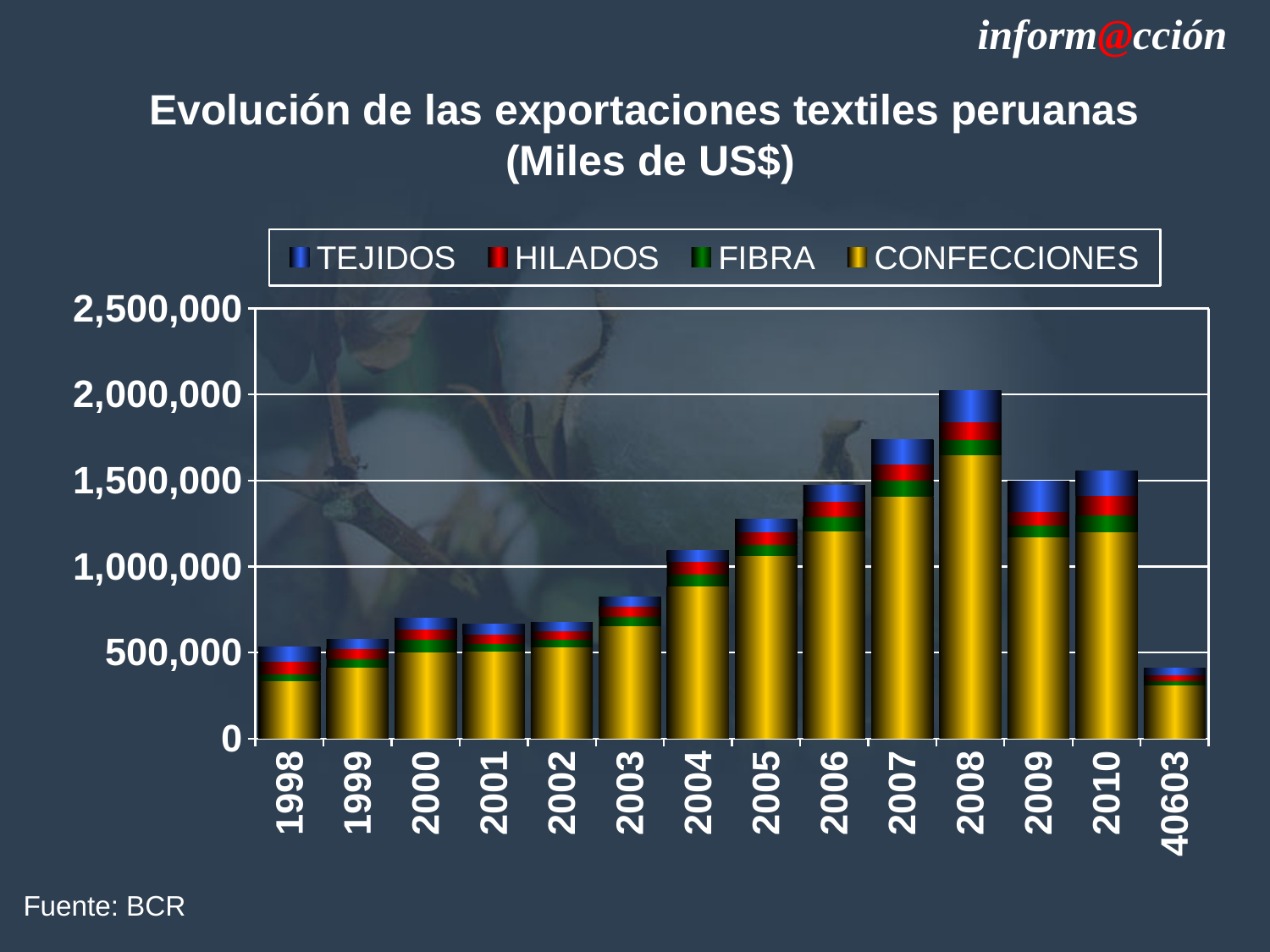
Is the total value for 2007 greater or less than 1,500,000? greater Is the total value for 2005 greater or less than 1,000,000? greater How many categories are shown along the x axis? 14 Is the total value for 2003 greater or less than 1,000,000? less Which year has the highest total textile exports? 2008 Which category has the lowest total textile exports? 40603 What kind of chart is shown on the slide? Stacked bar chart Which year has a larger total, 2007 or 2010? 2007 Do total textile exports rise or fall from 1998 to 2008? rise Which series is shown in yellow in the legend? CONFECCIONES How many series does the legend list? 4